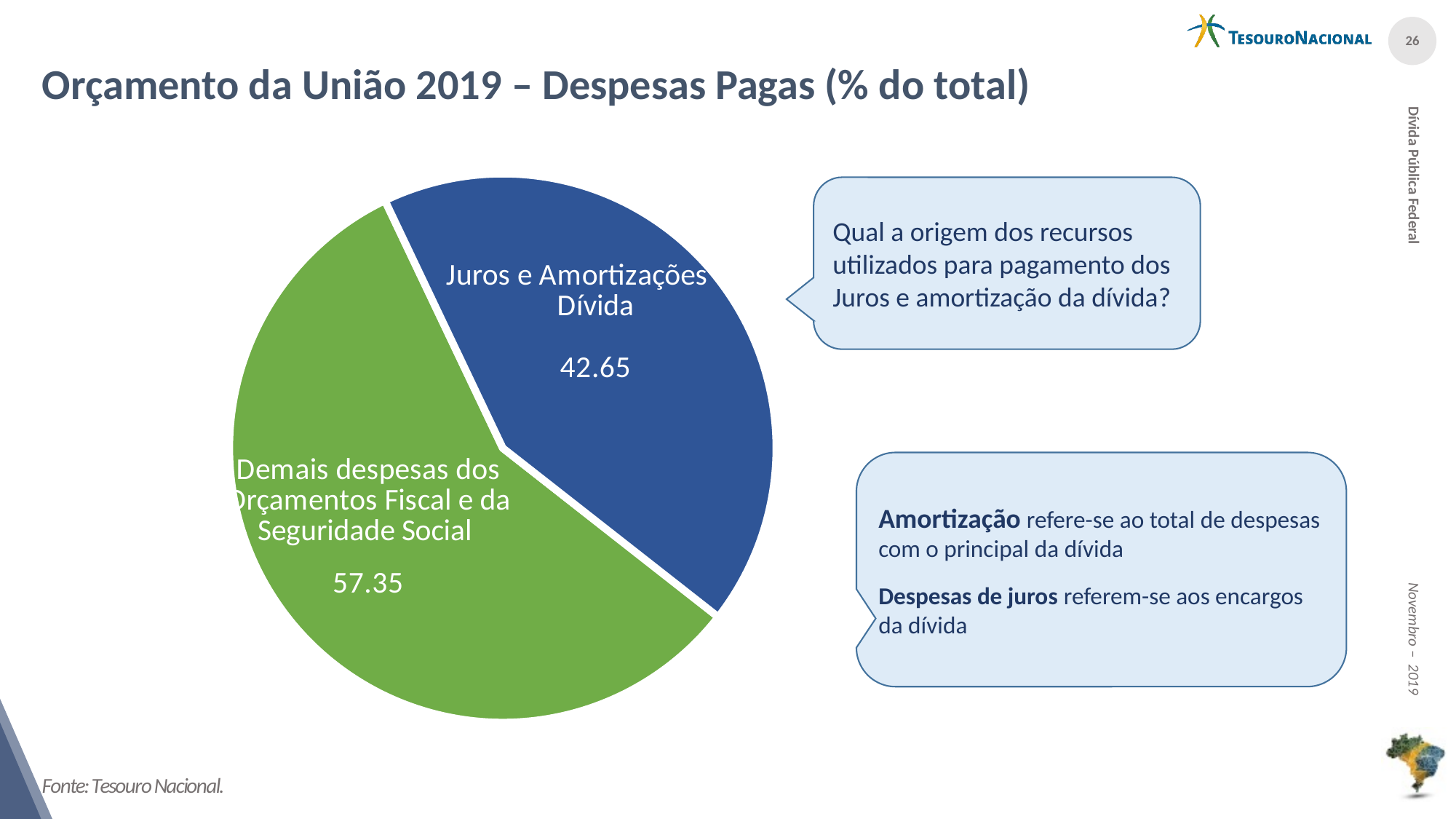
What is the title of the slide containing the chart? Orçamento da União 2019 – Despesas Pagas (% do total) Which slice is the smallest? Juros e Amortizações Dívida What colour is the Juros e Amortizações Dívida slice? blue What is the difference between the two slices' values? 14.70 What kind of chart is shown on the slide? pie chart What is the value for Juros e Amortizações Dívida? 42.65 Which is larger: Juros e Amortizações Dívida or Demais despesas dos Orçamentos Fiscal e da Seguridade Social? Demais despesas dos Orçamentos Fiscal e da Seguridade Social What is the value for Demais despesas dos Orçamentos Fiscal e da Seguridade Social? 57.35 Which slice is the largest? Demais despesas dos Orçamentos Fiscal e da Seguridade Social What share of the total does Juros e Amortizações Dívida represent? 42.65% How many slices does the pie chart have? 2